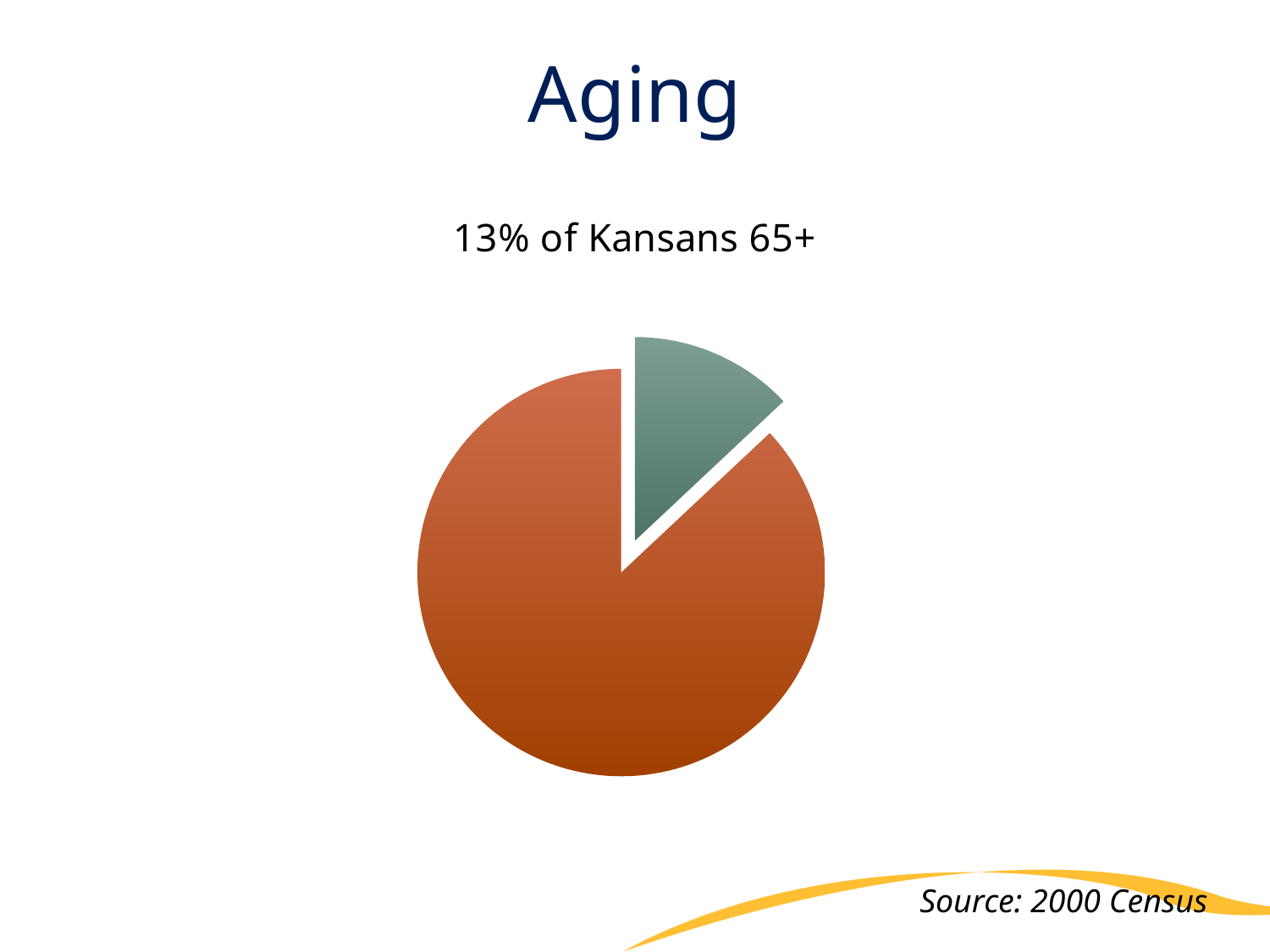
Which slice of the pie is the smallest? the green slice (Kansans 65+) How many slices does the pie chart have? 2 Is the share of the orange slice greater or less than 50%? greater Which slice of the pie is larger, the green slice or the orange slice? the orange slice Is the share of the green slice greater or less than 25%? less What kind of chart is shown on the slide? pie chart What is the title of the slide containing the pie chart? Aging What share of the pie does the large orange slice represent? 87% What source is cited for the data in the pie chart? 2000 Census What share of the pie does the small green slice (Kansans 65+) represent? 13%